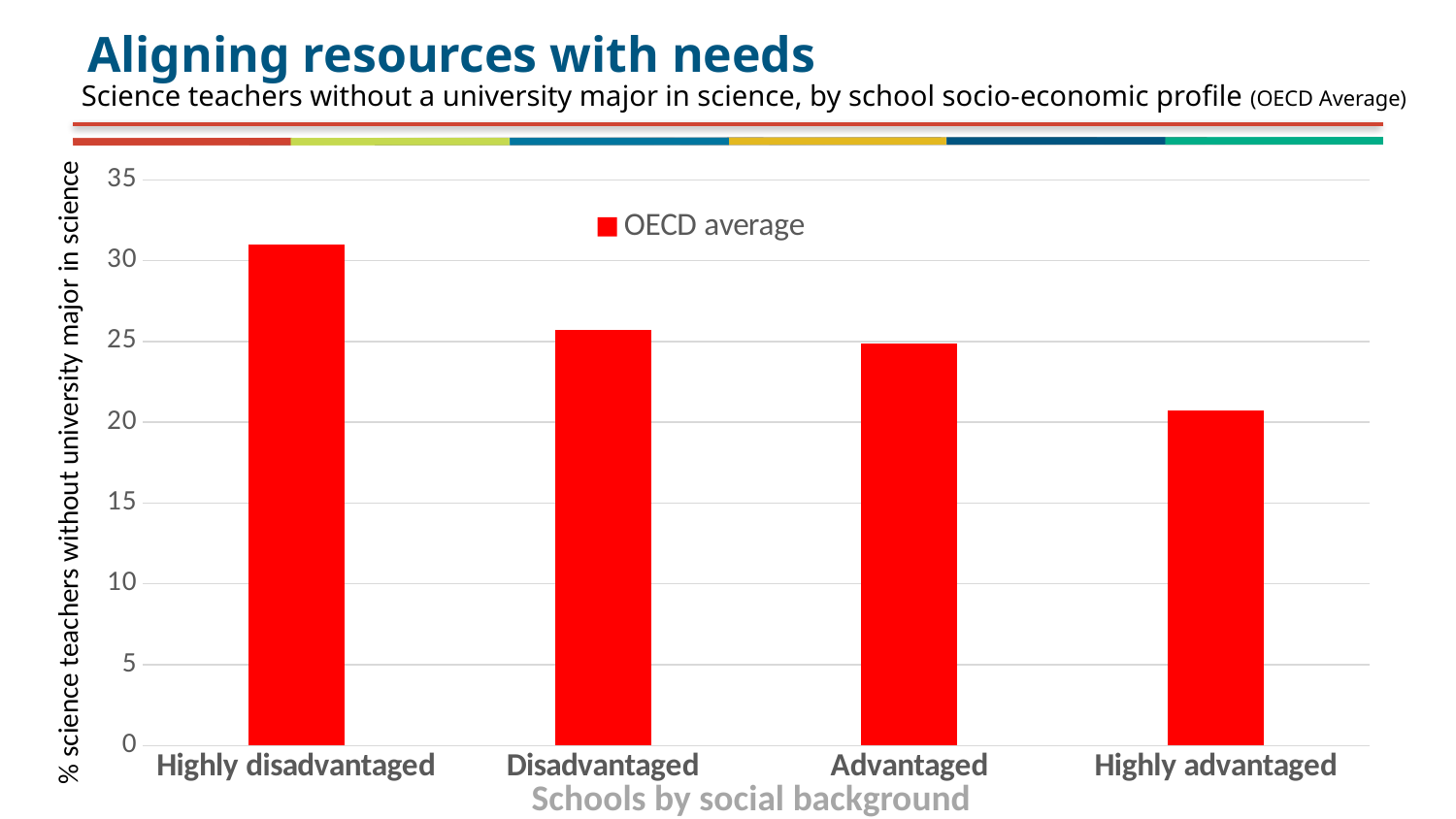
What kind of chart is shown on the slide? bar chart Is the value for Advantaged schools greater or less than 30? less Which school category has the highest percentage of science teachers without a university major in science? Highly disadvantaged Which is larger, the value for Highly disadvantaged schools or the value for Highly advantaged schools? Highly disadvantaged Is the value for Highly disadvantaged schools greater or less than 30? greater Which school category has the lowest percentage of science teachers without a university major in science? Highly advantaged Do the values rise or fall moving from Highly disadvantaged to Highly advantaged along the x axis? fall What is the name of the series shown in the legend? OECD average How many categories are shown on the x axis? 4 Is the value for Highly advantaged schools greater or less than 25? less How many series does the legend list? 1